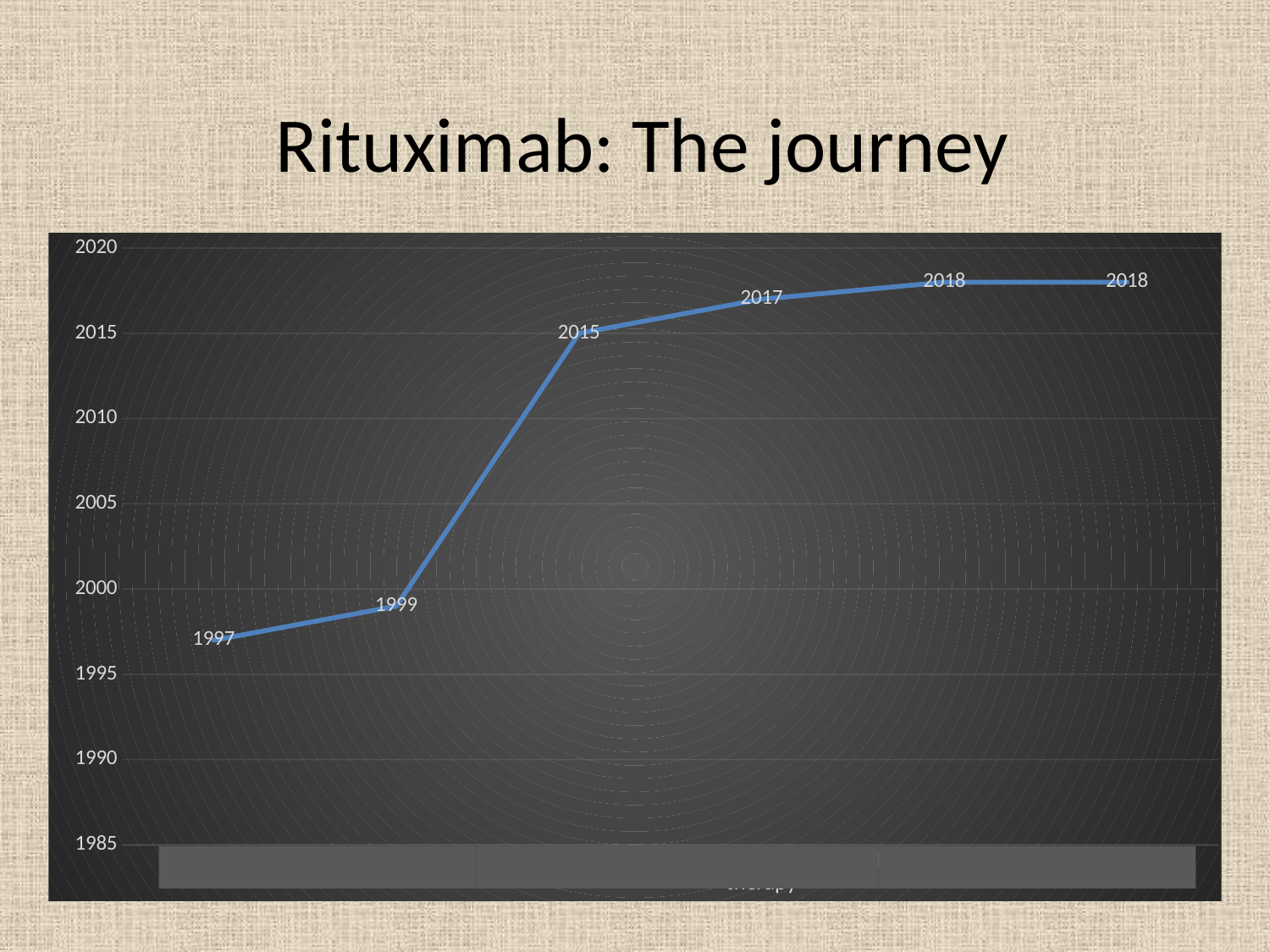
What is the highest value plotted on the line? 2018 What is the value of the second data point from the left? 1999 Do the values rise or fall from left to right along the line? rise What is the value of the last (rightmost) data point on the line? 2018 What is the difference between the third data point (2015) and the second data point (1999)? 16 What is the value of the third data point from the left? 2015 How many data points are plotted on the line? 6 What is the title of the slide containing the chart? Rituximab: The journey What is the lowest value plotted on the line? 1997 Which is larger, the value of the fourth data point or the value of the first data point? the fourth data point What is the value of the first (leftmost) data point on the line? 1997 What kind of chart is shown on the slide? line chart